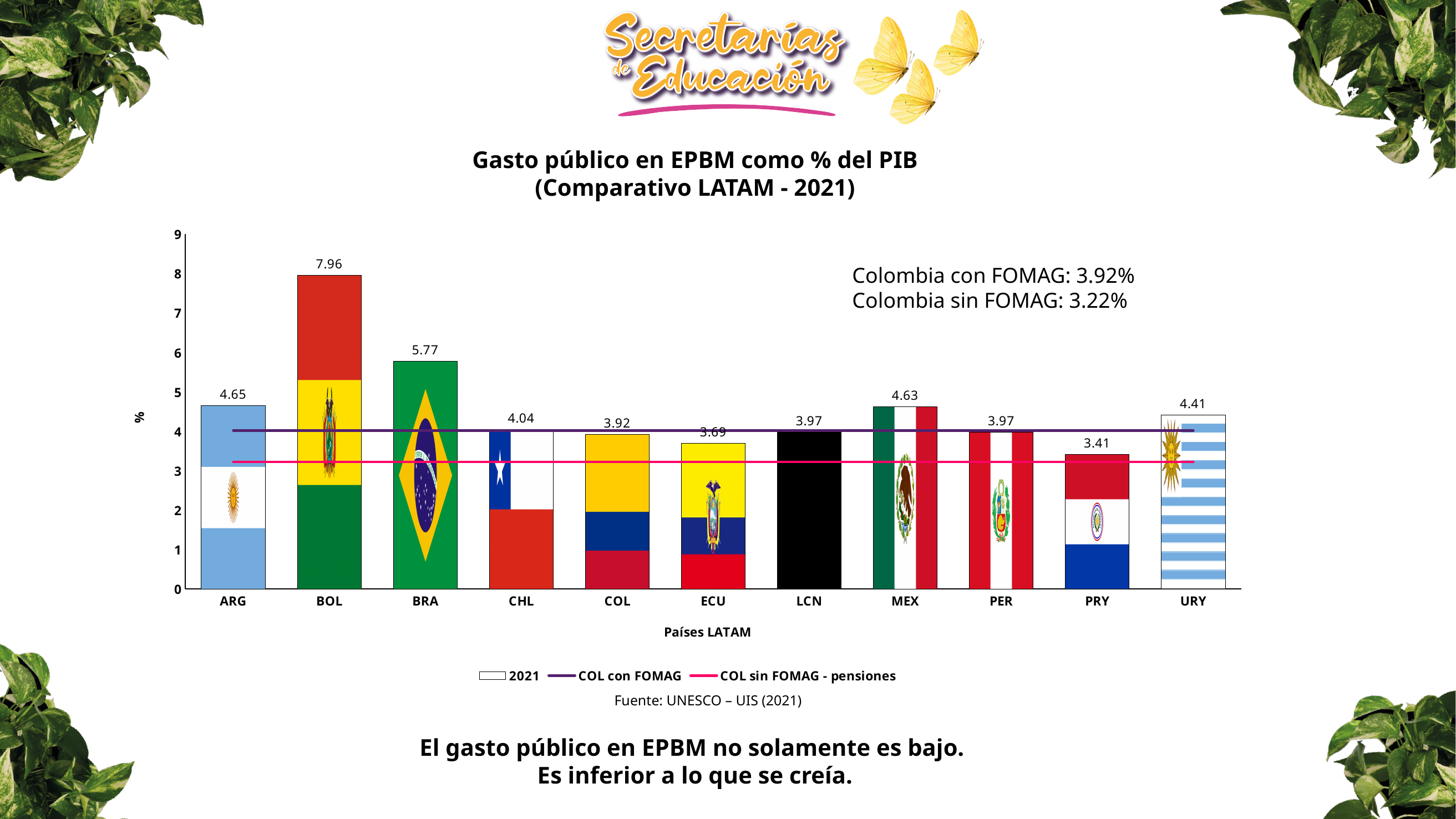
What is the difference between the values for BOL and BRA? 2.19 Which is larger, the value for CHL or the value for ECU? CHL What is the value for BOL? 7.96 What is the value for PRY? 3.41 How many entries does the legend list? 3 How many countries are shown on the x axis? 11 Which country has the highest value? BOL What is the source cited below the chart? UNESCO – UIS (2021) Which country has the lowest value? PRY What is the value for URY? 4.41 What is the difference between the values for ARG and MEX? 0.02 What kind of chart is this? combination bar and line chart